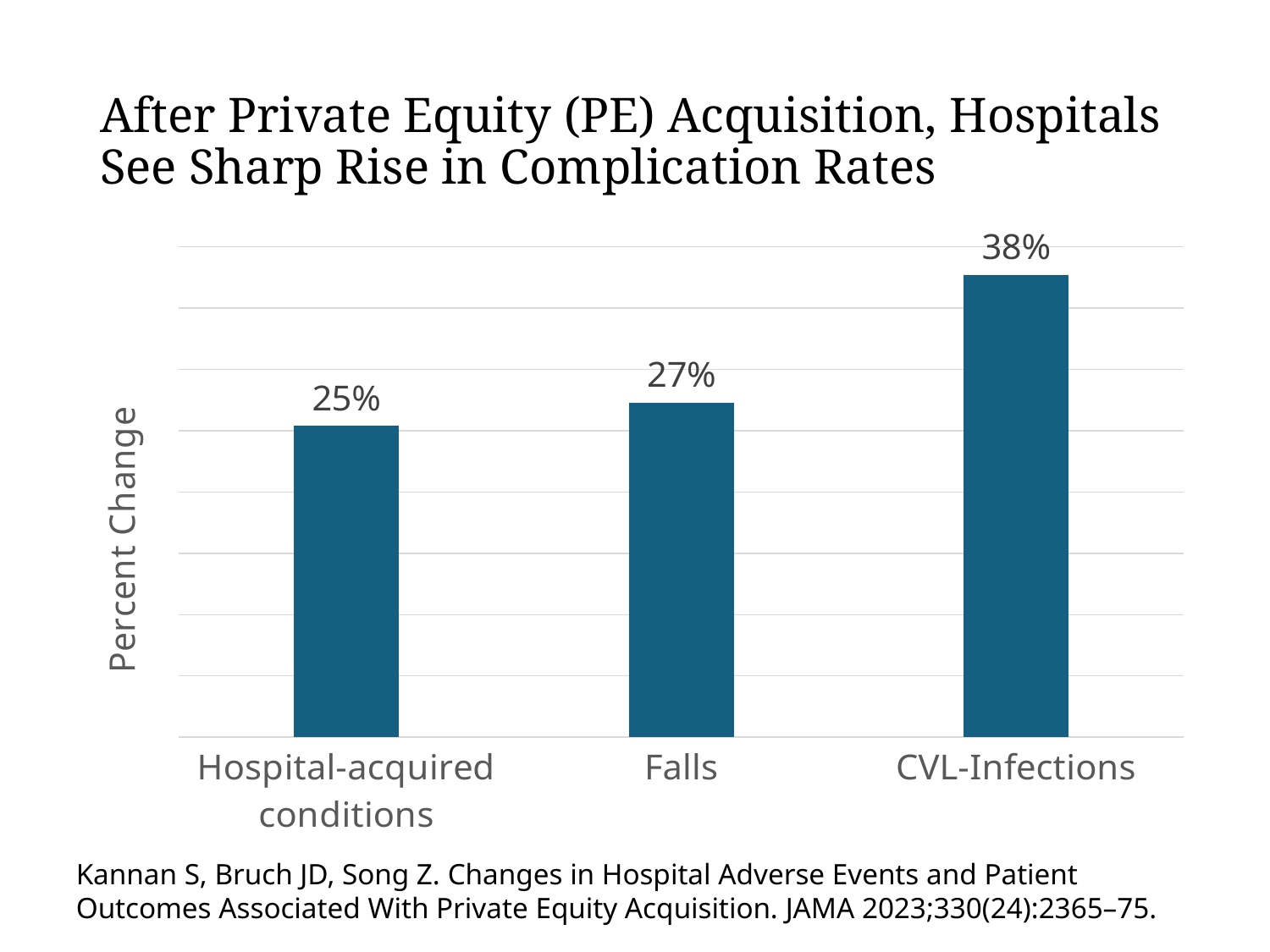
Which category has the highest percent change? CVL-Infections Do the values rise or fall moving from left to right across the categories? Rise What is the label on the vertical axis of the chart? Percent Change What is the percent change for CVL-Infections? 38% How many categories are shown in the chart? 3 What is the difference in percent change between Falls and Hospital-acquired conditions? 2% What is the difference in percent change between CVL-Infections and Falls? 11% Which category has the lowest percent change? Hospital-acquired conditions What is the percent change for Hospital-acquired conditions? 25% What is the percent change for Falls? 27% What kind of chart is shown on the slide? Bar chart Which has a larger percent change, CVL-Infections or Hospital-acquired conditions? CVL-Infections